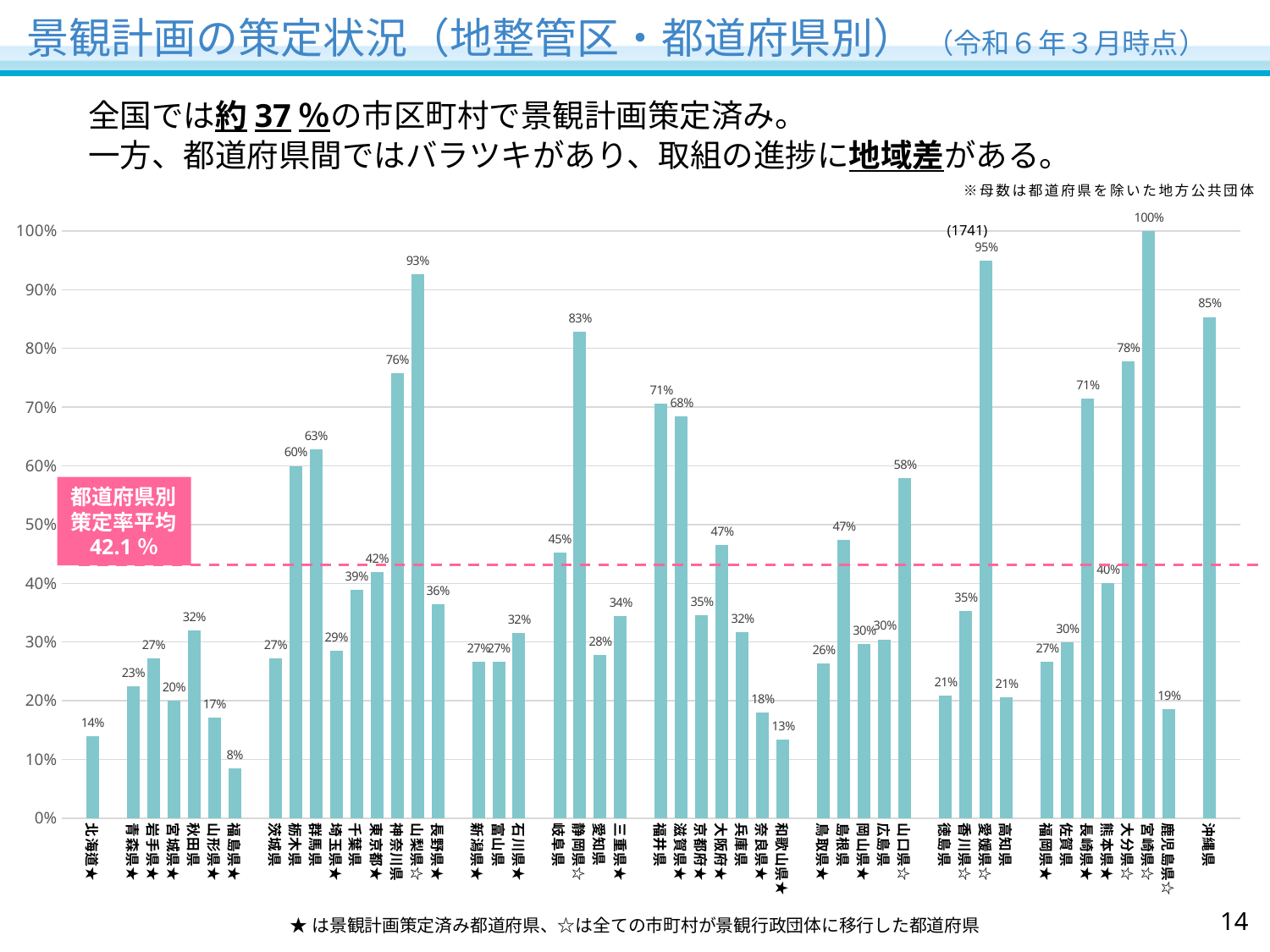
What is the difference between the values for 静岡県 and 愛知県? 55% What is the 都道府県別策定率平均 value shown by the dashed line in the chart? 42.1% What is the value for 大分県 in the chart? 78% Is the value for 愛媛県 greater or less than 90%? greater What is the value for 沖縄県 in the chart? 85% Which prefecture has the highest value in the chart? 宮崎県 What kind of chart is shown on the slide? bar chart Which has a larger value, 神奈川県 or 長野県? 神奈川県 How many prefectures (bars) are shown in the chart? 47 Which prefecture has the lowest value in the chart? 福島県 What is the value for 福島県 in the chart? 8% What is the value for 山梨県 in the chart? 93%